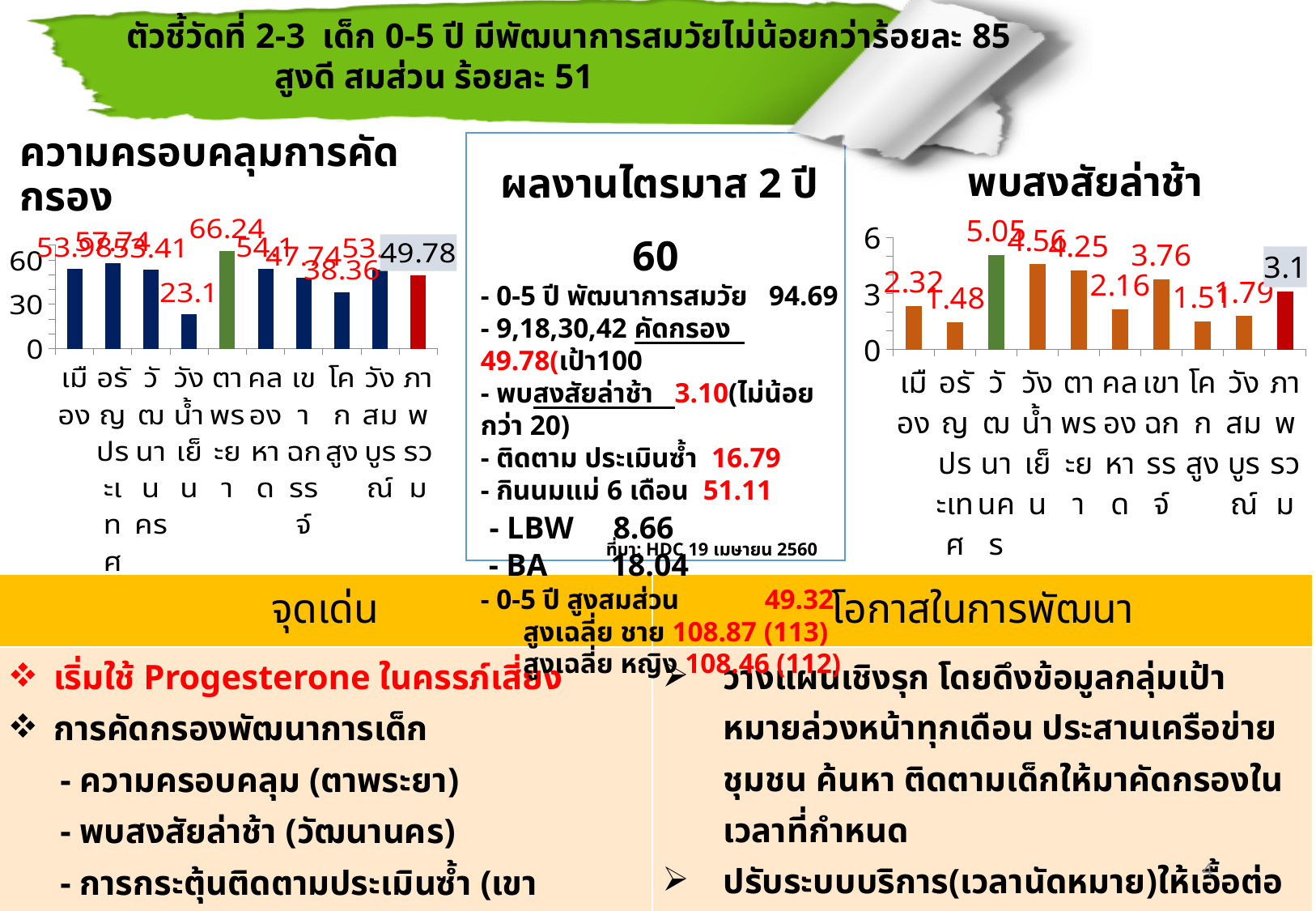
In the right chart (พบสงสัยล่าช้า), what is the value for ภาพรวม? 3.1 In the left chart (ความครอบคลุมการคัดกรอง), what is the value for ภาพรวม? 49.78 In the left chart (ความครอบคลุมการคัดกรอง), which category has the highest value? ตาพระยา In the right chart (พบสงสัยล่าช้า), which is larger, the value for เขาฉกรรจ์ or the value for คลองหาด? เขาฉกรรจ์ In the left chart (ความครอบคลุมการคัดกรอง), what is the difference between the values for ตาพระยา and วังน้ำเย็น? 43.14 In the left chart (ความครอบคลุมการคัดกรอง), which category has the lowest value? วังน้ำเย็น In the right chart (พบสงสัยล่าช้า), what is the difference between the values for วัฒนานคร and เมือง? 2.73 What kind of chart is the right chart (พบสงสัยล่าช้า)? bar chart In the right chart (พบสงสัยล่าช้า), which category has the highest value? วัฒนานคร In the left chart (ความครอบคลุมการคัดกรอง), is the value for โคกสูง greater or less than 30? greater In the left chart (ความครอบคลุมการคัดกรอง), what is the value for ตาพระยา? 66.24 How many categories are shown in the left chart (ความครอบคลุมการคัดกรอง)? 10